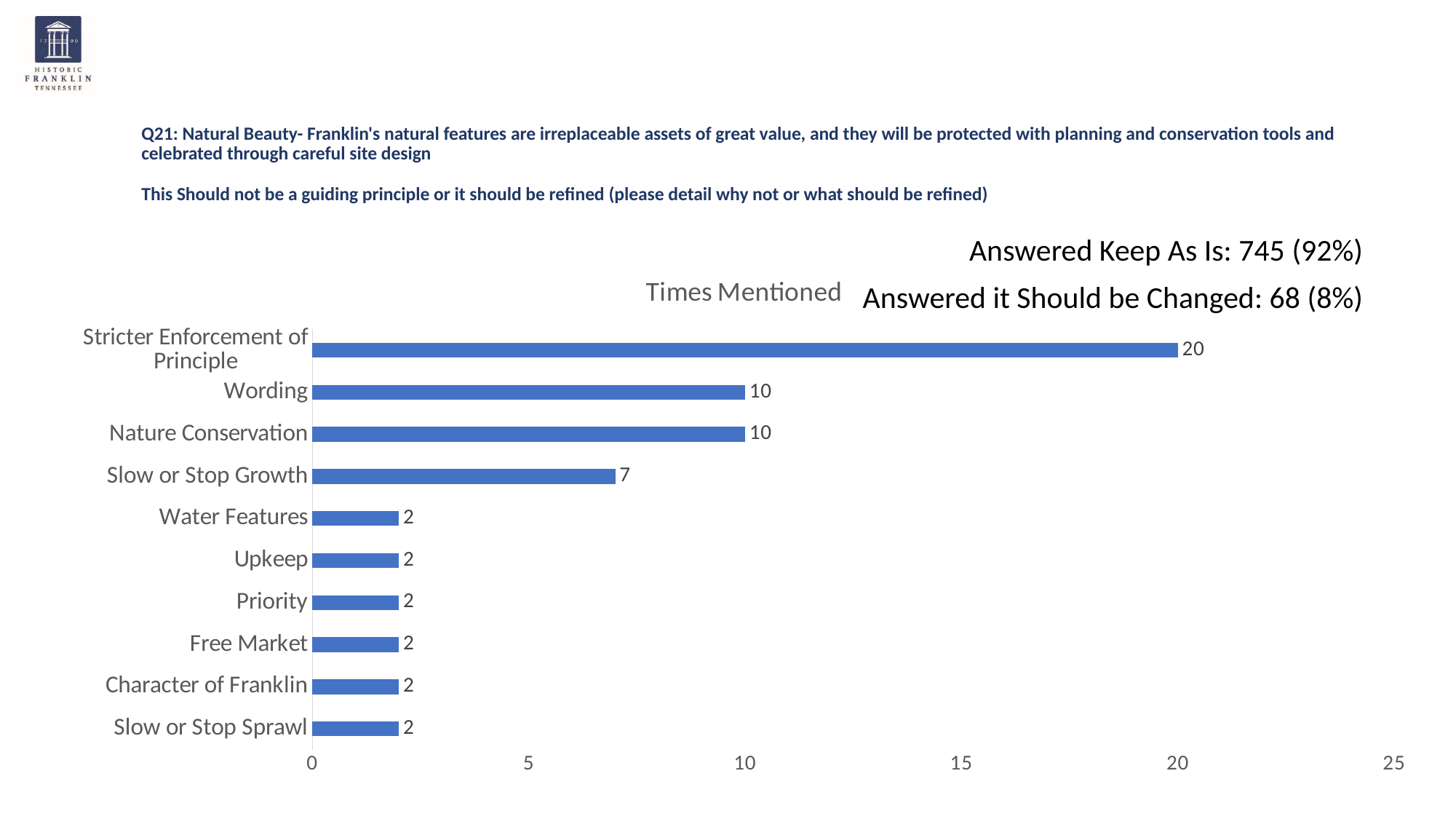
What is the title of the chart? Times Mentioned Is the value for Stricter Enforcement of Principle greater or less than 15? greater What is the value for Nature Conservation? 10 What is the difference between Stricter Enforcement of Principle and Wording? 10 Which category has the highest value? Stricter Enforcement of Principle How many times was Slow or Stop Growth mentioned? 7 What kind of chart is shown? Bar chart What is the value for Stricter Enforcement of Principle? 20 How many categories have a value of 2? 6 What is the difference between Slow or Stop Growth and Water Features? 5 Which is larger, Wording or Slow or Stop Growth? Wording How many categories are shown in the chart? 10